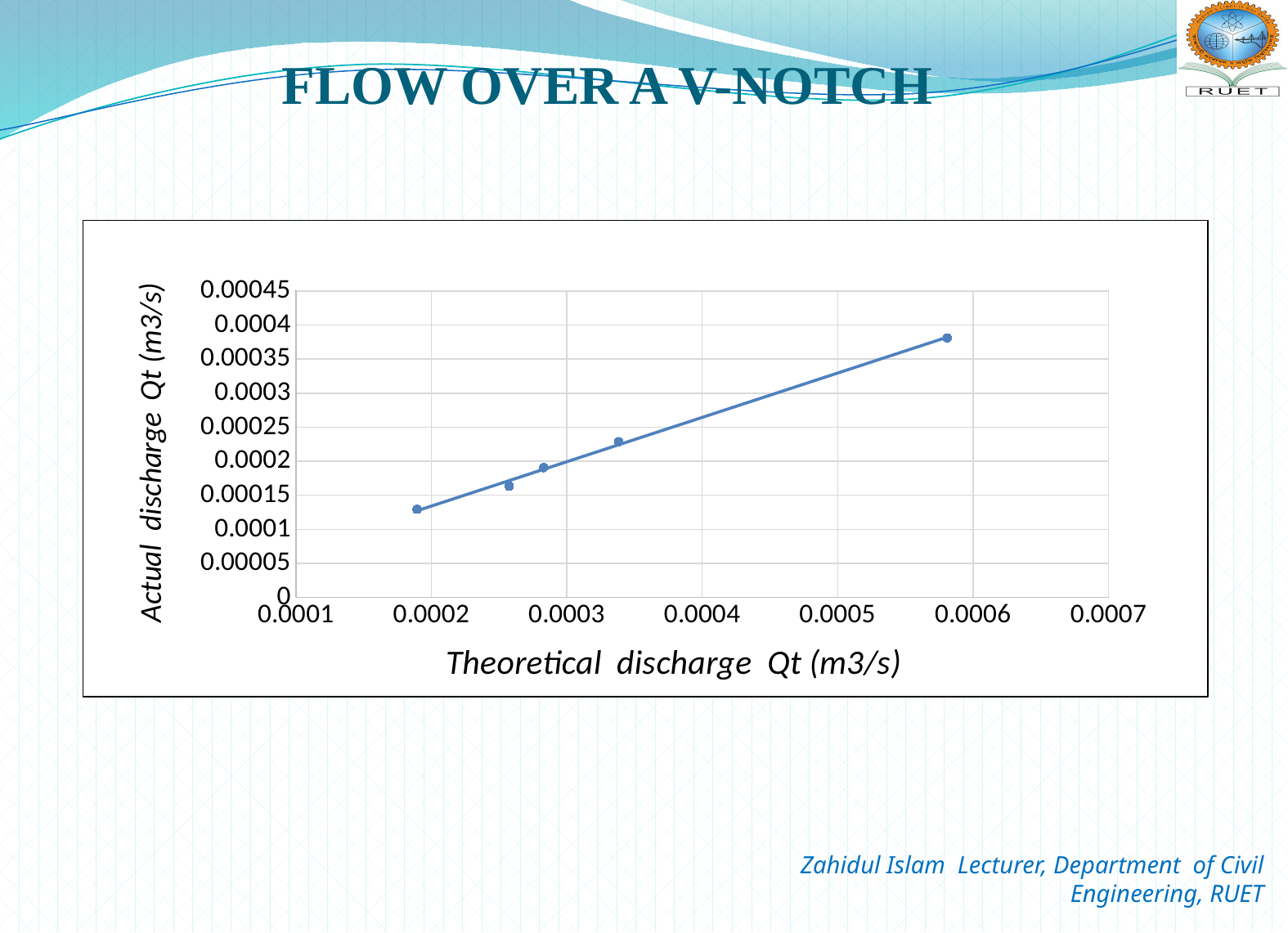
Is the actual discharge of the leftmost data point greater or less than 0.00015? less What is the label of the x axis? Theoretical discharge Qt (m3/s) What kind of chart is shown on the slide? scatter chart Do the plotted values rise or fall as theoretical discharge increases along the x axis? rise How many data points are plotted on the chart? 5 What is the maximum value shown on the y axis? 0.00045 What is the label of the y axis? Actual discharge Qt (m3/s) Is the theoretical discharge of the leftmost data point greater or less than 0.0002? less Is the theoretical discharge of the rightmost data point greater or less than 0.0005? greater Which data point has the highest actual discharge, the leftmost or the rightmost? the rightmost